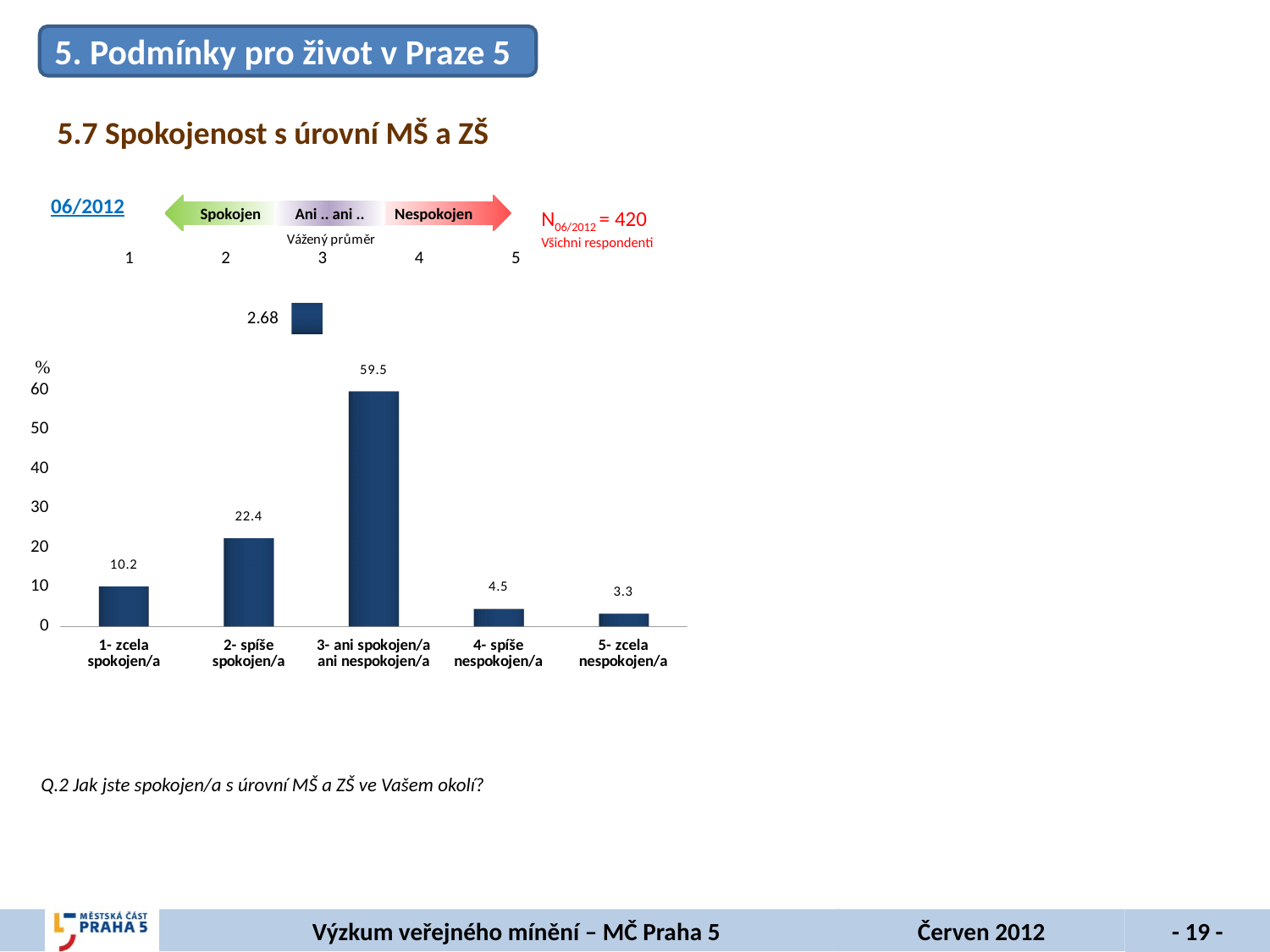
What is the value for the category '3- ani spokojen/a ani nespokojen/a'? 59.5 What is the value for the category '5- zcela nespokojen/a'? 3.3 What is the weighted average (Vážený průměr) shown above the chart? 2.68 Which category has the highest value? 3- ani spokojen/a ani nespokojen/a What is the value for the category '1- zcela spokojen/a'? 10.2 Which is larger, the value for '2- spíše spokojen/a' or '4- spíše nespokojen/a'? 2- spíše spokojen/a Is the value for '3- ani spokojen/a ani nespokojen/a' greater or less than 50? greater What is the number of respondents (N) shown on the slide? 420 What kind of chart is shown on the slide? bar chart Which category has the lowest value? 5- zcela nespokojen/a What is the difference between the values for '2- spíše spokojen/a' and '1- zcela spokojen/a'? 12.2 How many categories are shown on the x axis of the bar chart? 5